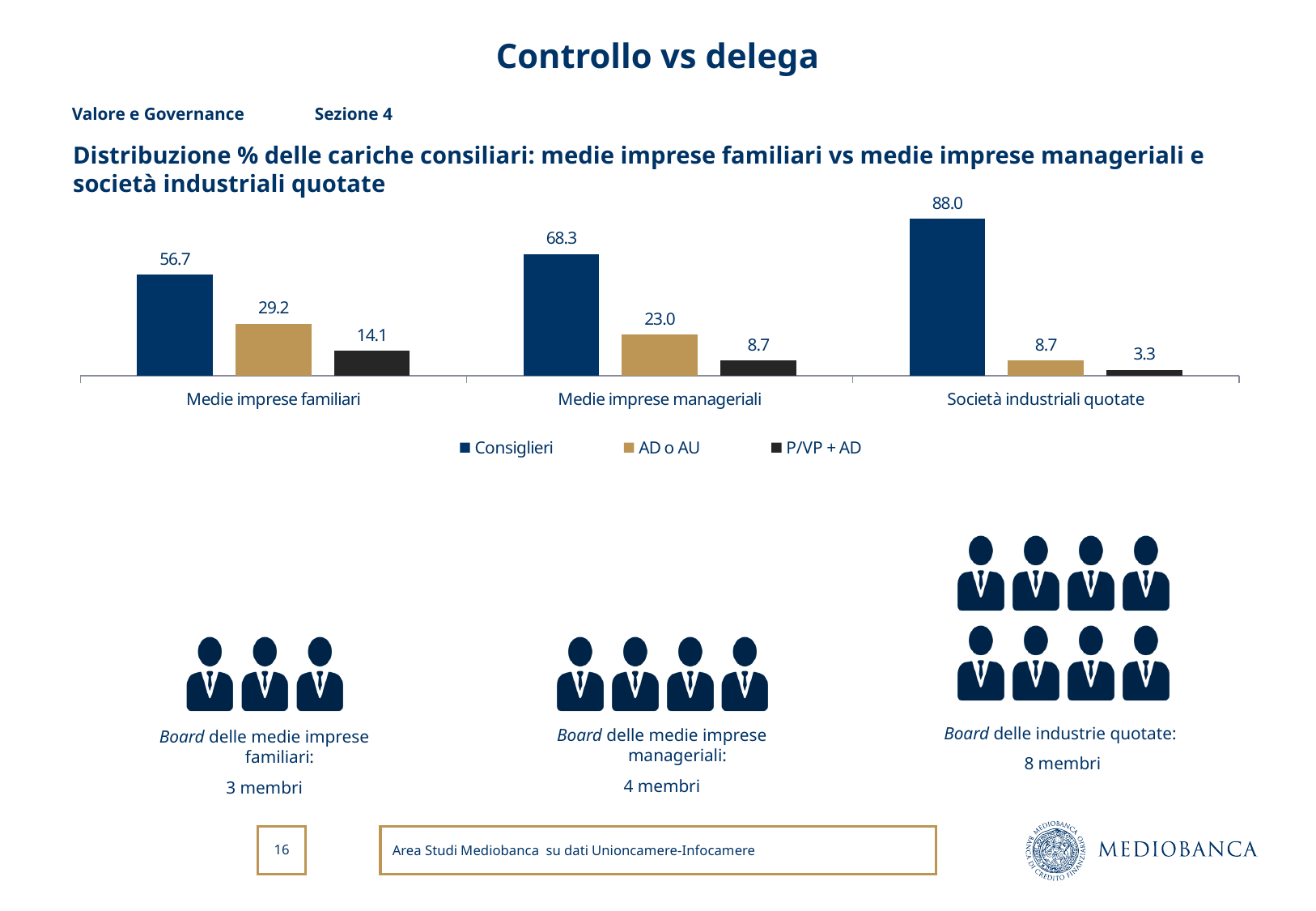
How many series does the legend list? 3 How many categories are shown on the x axis? 3 Which series is shown in gold/tan colour in the legend? AD o AU What is the difference between the Consiglieri values for Società industriali quotate and Medie imprese familiari? 31.3 What kind of chart is shown on the slide? Bar chart What is the value for P/VP + AD in the Società industriali quotate category? 3.3 What is the value for AD o AU in the Medie imprese manageriali category? 23.0 Which category has the highest value for Consiglieri? Società industriali quotate What is the value for Consiglieri in the Medie imprese familiari category? 56.7 Which is larger: the AD o AU value for Medie imprese familiari or for Medie imprese manageriali? Medie imprese familiari Which category has the lowest value for AD o AU? Società industriali quotate Do the P/VP + AD values rise or fall moving from Medie imprese familiari to Società industriali quotate? Fall